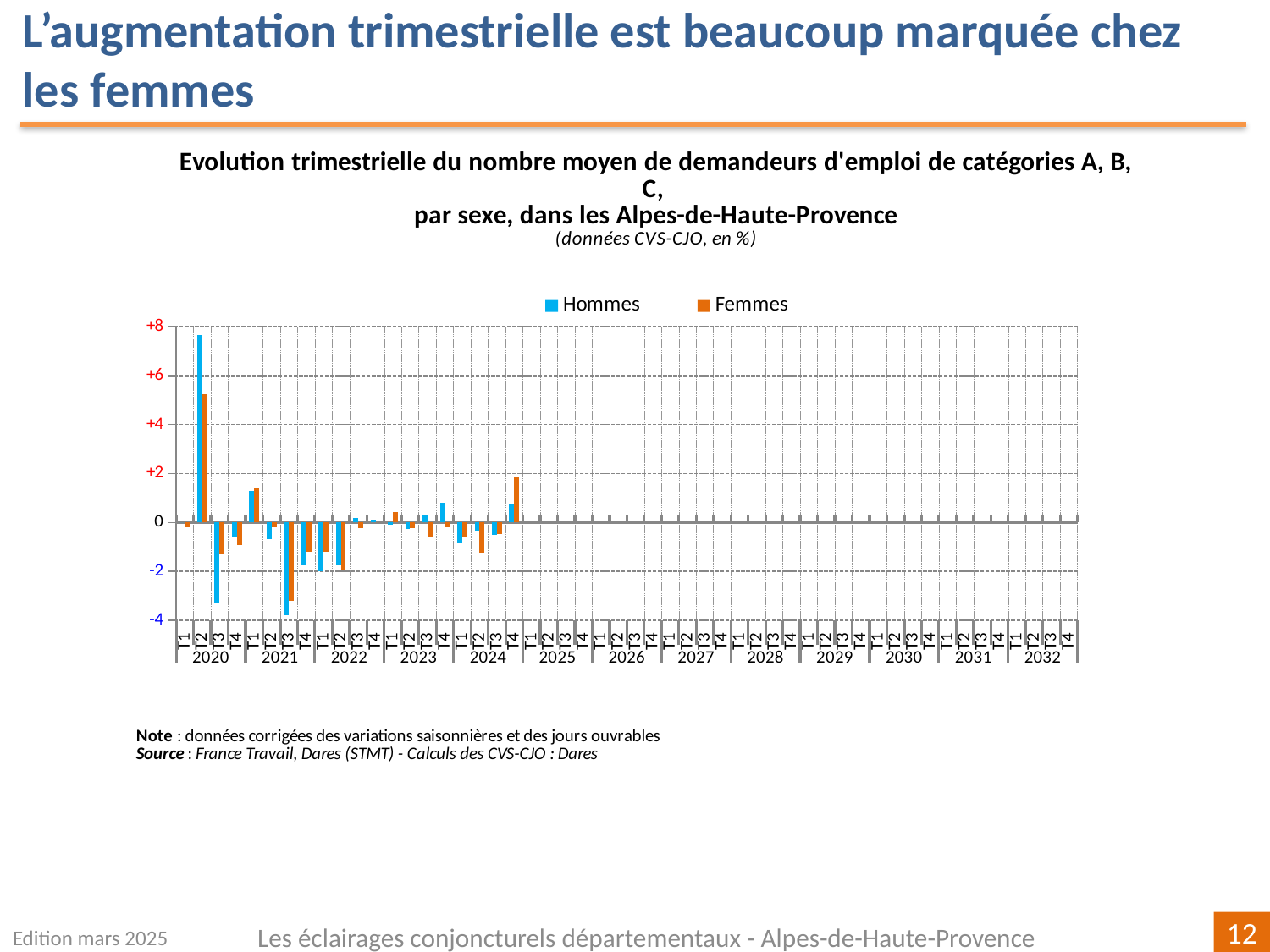
In which quarter is the value for Hommes the highest? T2 2020 What kind of chart is shown on the slide? Bar chart In T2 2020, which series has the larger value, Hommes or Femmes? Hommes Is the value for Hommes in T2 2020 greater or less than +6? greater Is the value for Hommes in T3 2021 greater or less than -2? less In which quarter is the value for Femmes the highest? T2 2020 In T4 2024, which series has the larger value, Hommes or Femmes? Femmes Is the value for Femmes in T2 2020 greater or less than +4? greater How many years are labelled along the x axis? 13 Which series is shown in orange in the legend? Femmes How many series does the legend list? 2 In which quarter is the value for Femmes the lowest? T3 2021